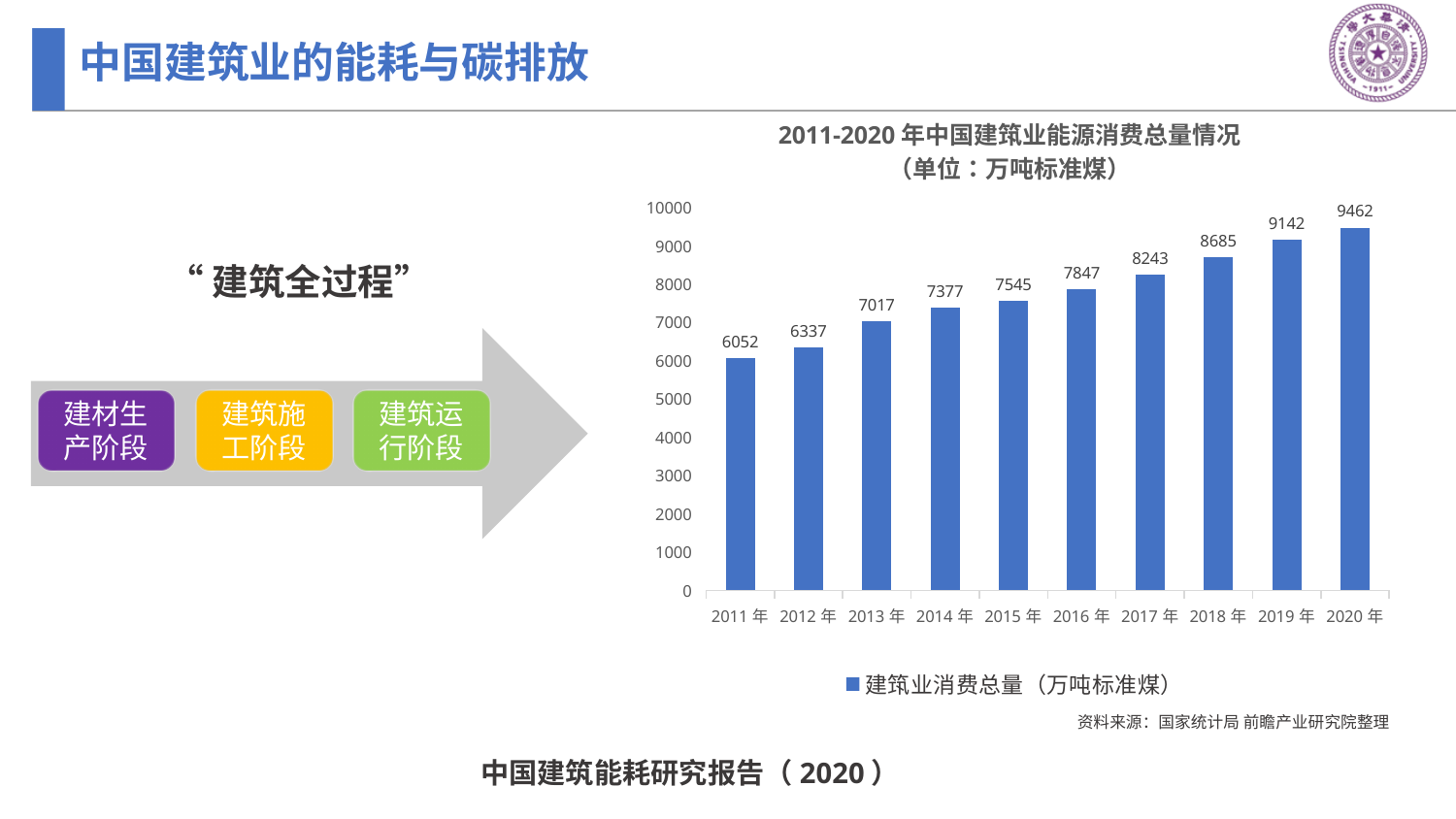
Is the value for 2019 年 greater or less than 9000? greater What is the value for 2018 年 in the chart? 8685 Which year has the lowest value in the chart? 2011 年 What is the value for 2015 年 in the chart? 7545 Which is larger, the value for 2013 年 or the value for 2014 年? 2014 年 How many years are shown on the x axis of the chart? 10 Do the values rise or fall from 2011 年 to 2020 年? rise What is the difference between the values for 2020 年 and 2011 年? 3410 What is the difference between the values for 2017 年 and 2016 年? 396 What kind of chart is shown on the slide? bar chart Which year has the highest value in the chart? 2020 年 How many series does the legend list? 1